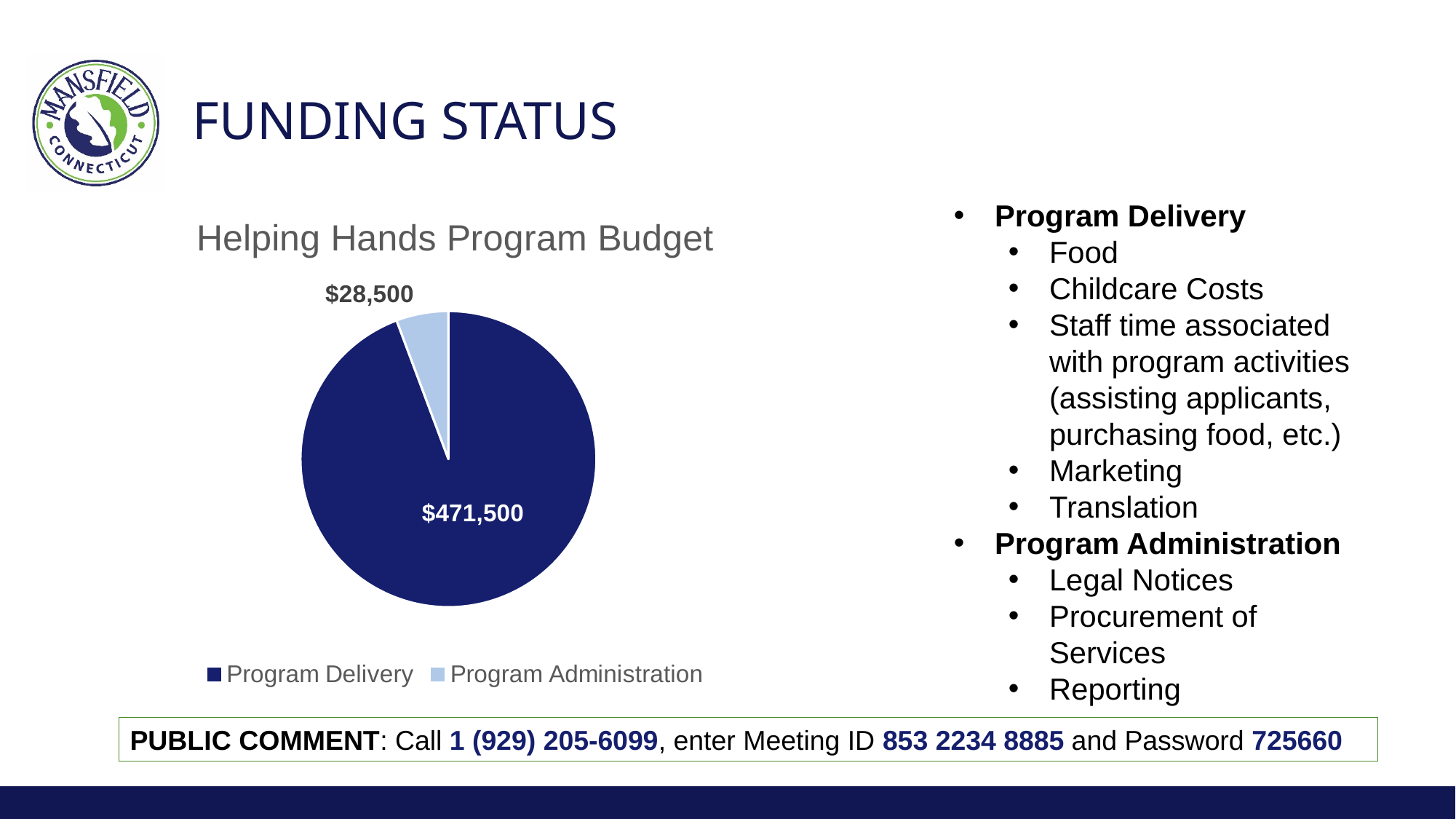
What is the title of the chart? Helping Hands Program Budget Which category has the smallest slice of the pie? Program Administration How many categories does the pie chart show? 2 What is the value for Program Delivery in the Helping Hands Program Budget chart? $471,500 What is the value for Program Administration in the Helping Hands Program Budget chart? $28,500 How many entries does the legend list? 2 What share of the total budget does Program Administration represent? 5.7% Which is larger, Program Delivery or Program Administration? Program Delivery What is the difference between the Program Delivery and Program Administration values? $443,000 Which category has the largest slice of the pie? Program Delivery What kind of chart is shown on the slide? Pie chart What is the total of the two values shown in the pie chart? $500,000